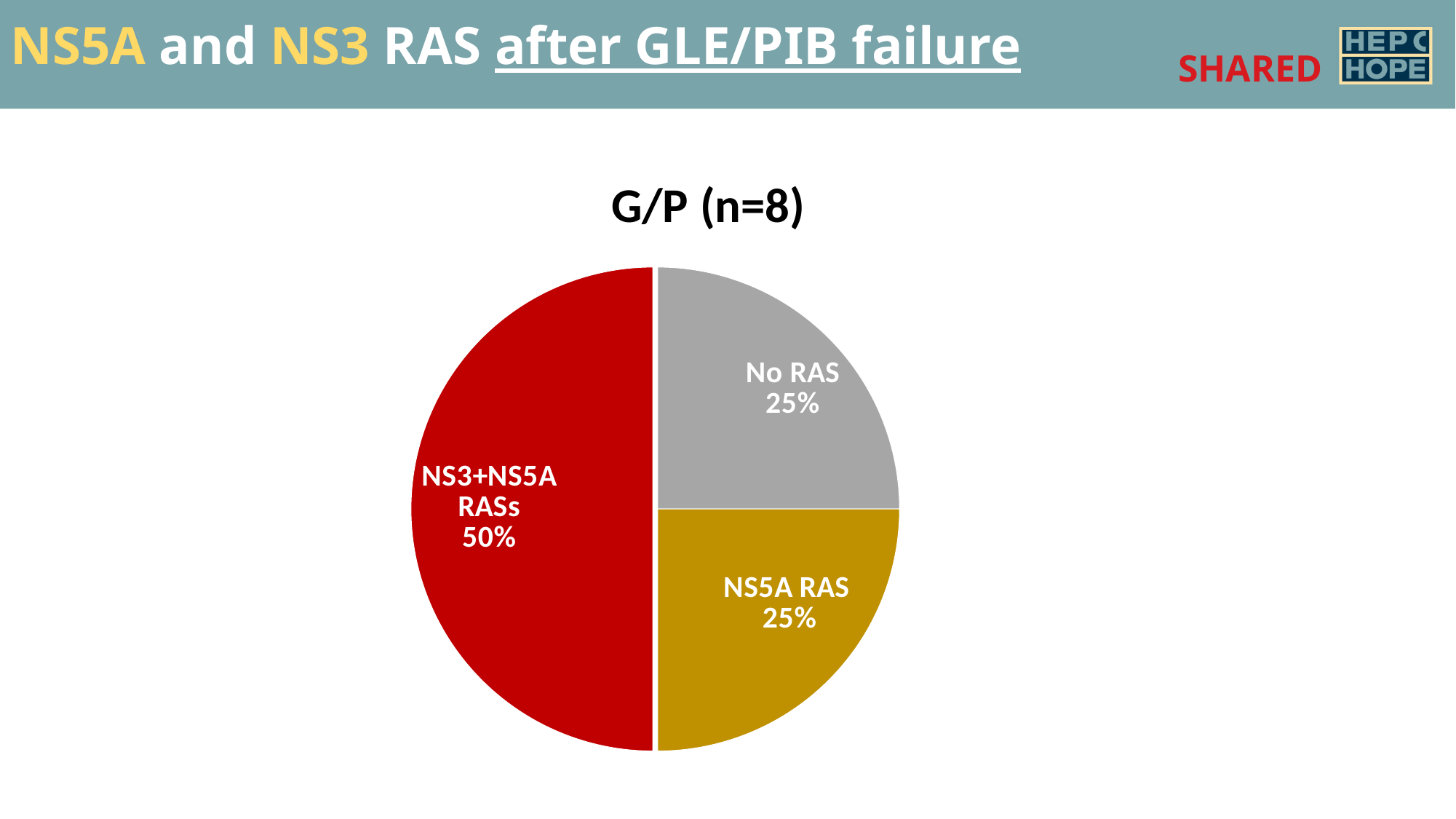
What is the title of the pie chart? G/P (n=8) What share of the pie is labelled NS3+NS5A RASs? 50% Which is larger, the NS3+NS5A RASs slice or the NS5A RAS slice? NS3+NS5A RASs How many slices does the pie chart have? 3 Which slice of the pie chart is the largest? NS3+NS5A RASs What share of the pie is labelled NS5A RAS? 25% What is the combined share of the No RAS and NS5A RAS slices? 50% What share of the pie is labelled No RAS? 25% How many patients (n) does the pie chart title indicate? 8 What is the difference in percentage points between the NS3+NS5A RASs slice and the No RAS slice? 25% What kind of chart is shown on the slide? Pie chart What colour is the NS3+NS5A RASs slice? Red